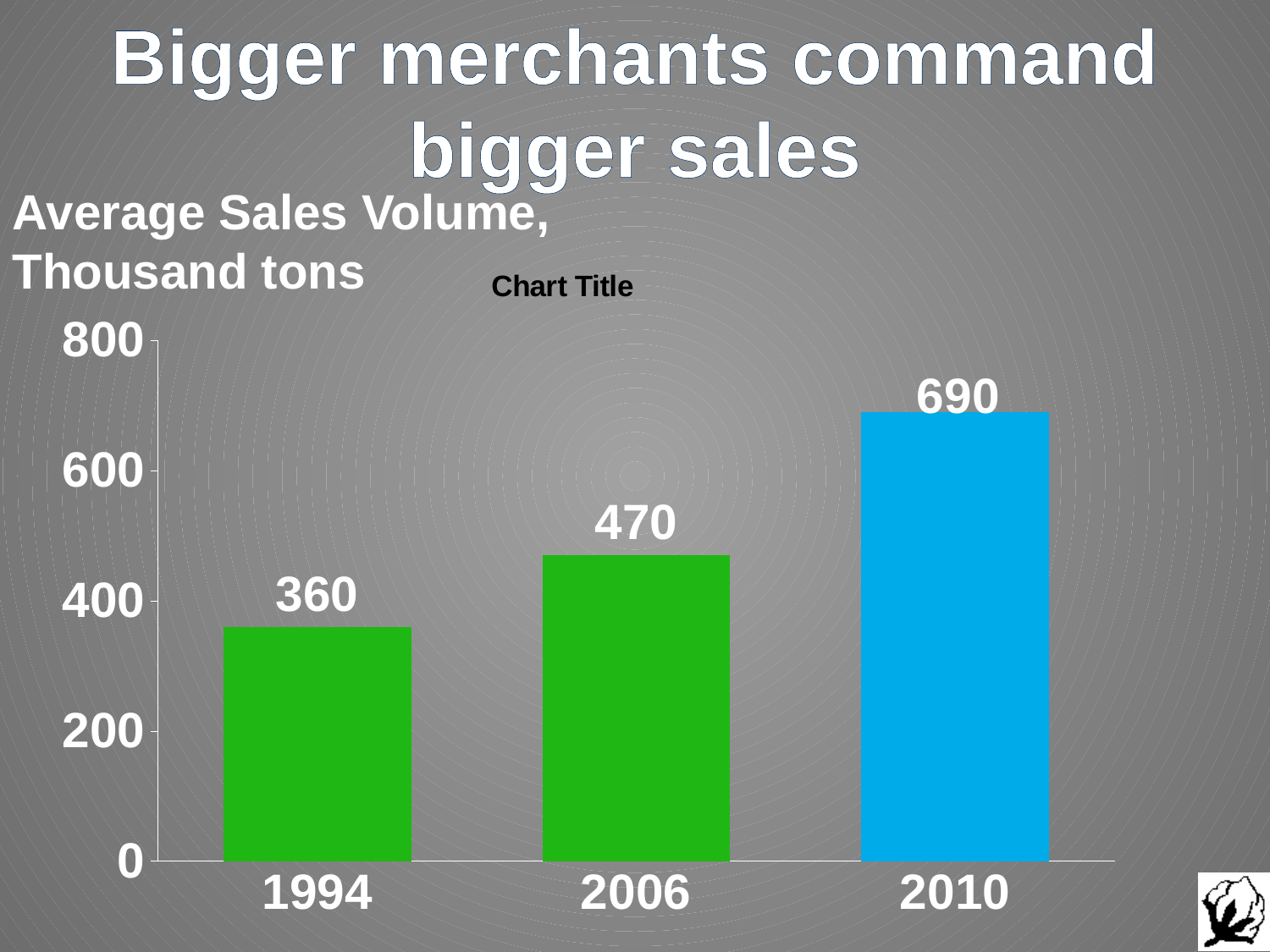
What is the difference between the values for 2010 and 1994? 330 What is the value for 2006? 470 What is the difference between the values for 2006 and 1994? 110 What is the value for 1994? 360 Which year has the highest value? 2010 How many years are shown on the chart? 3 What is the value for 2010? 690 Is the value for 2010 greater or less than 600? greater Which year has the lowest value? 1994 Do the values rise or fall from 1994 to 2010? rise What kind of chart is shown? bar chart Which is larger, the value for 2006 or the value for 2010? 2010